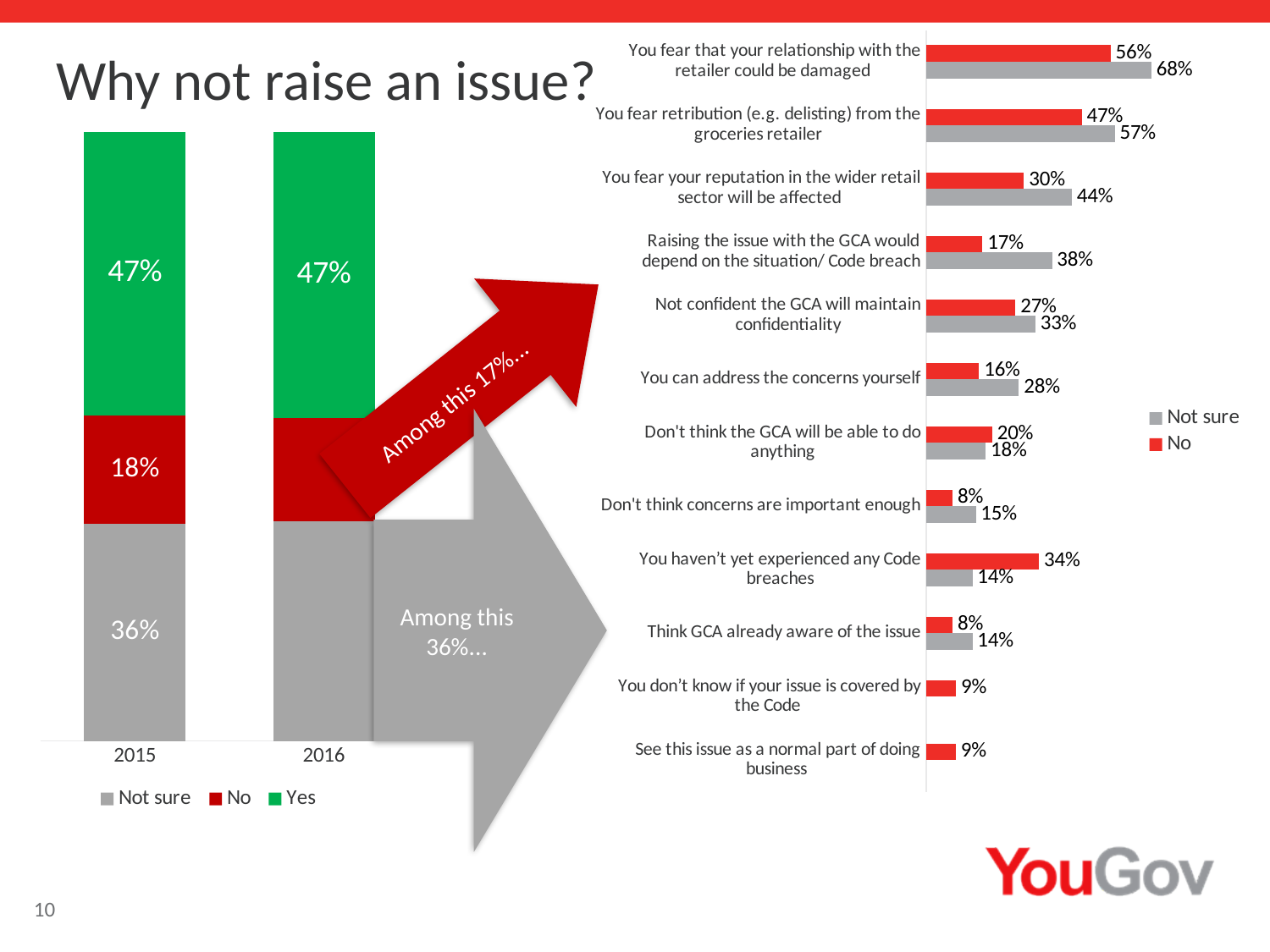
In the stacked bar chart on the left, what is the value for Not sure in 2015? 36% How many categories are shown in the horizontal bar chart on the right? 12 How many series does the legend of the stacked bar chart on the left list? 3 How many series does the legend of the horizontal bar chart on the right list? 2 What kind of chart is the chart on the left of the slide? Stacked bar chart In the stacked bar chart on the left, what is the value for No in 2015? 18% In the horizontal bar chart on the right, which category has the highest Not sure value? You fear that your relationship with the retailer could be damaged In the horizontal bar chart on the right, what is the Not sure value for 'You fear retribution (e.g. delisting) from the groceries retailer'? 57% In the horizontal bar chart on the right, what is the difference between the Not sure and No values for 'You fear your reputation in the wider retail sector will be affected'? 14% In the horizontal bar chart on the right, for 'You haven't yet experienced any Code breaches', which is larger: the No value or the Not sure value? No In the stacked bar chart on the left, what is the value for Yes in 2016? 47% In the horizontal bar chart on the right, what is the No value for 'You fear that your relationship with the retailer could be damaged'? 56%